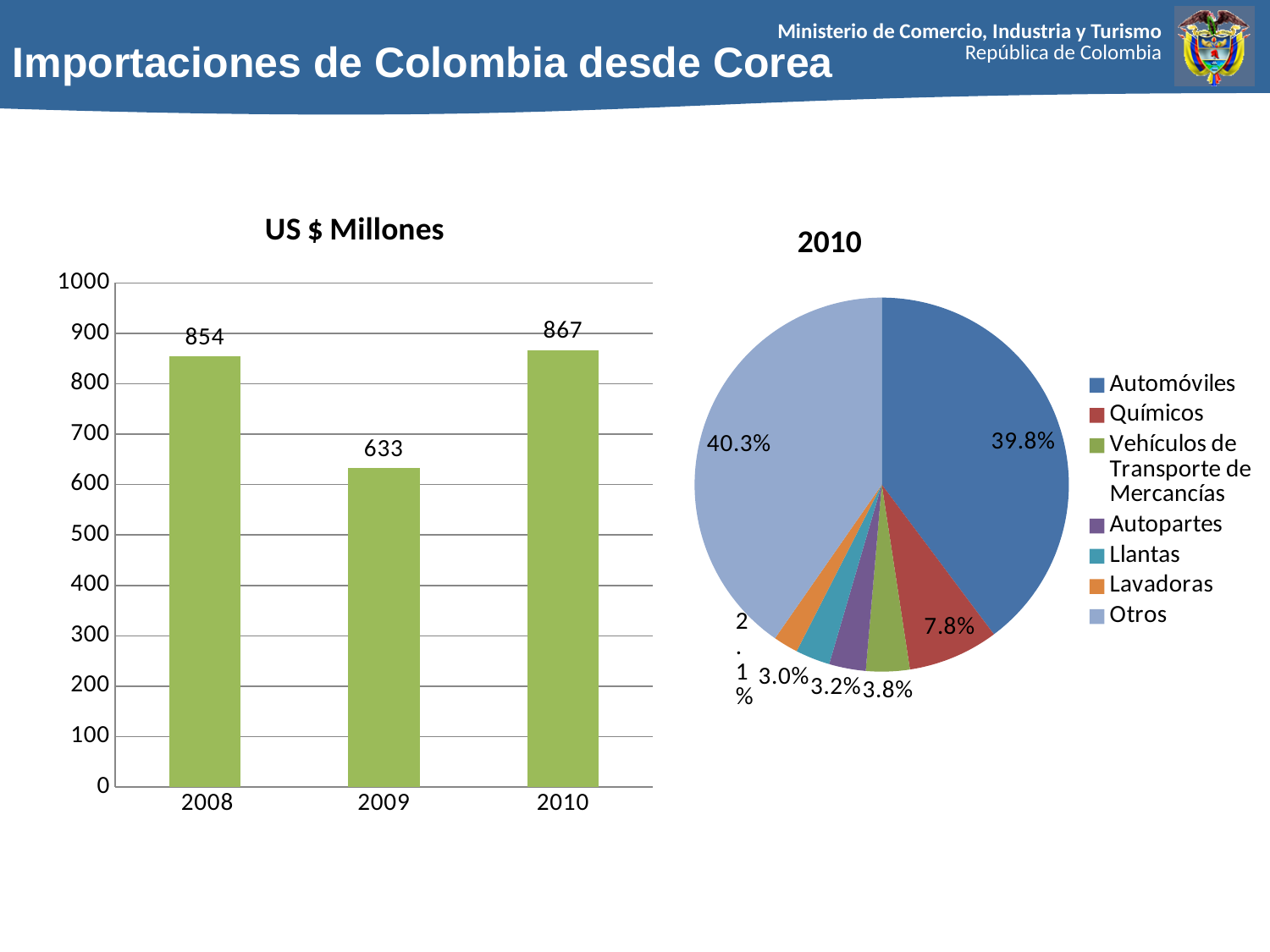
In the 'US $ Millones' bar chart, which is larger, the value for 2008 or the value for 2010? 2010 How many categories does the legend of the '2010' pie chart list? 7 How many bars are in the 'US $ Millones' bar chart? 3 In the 'US $ Millones' bar chart, what is the value for 2010? 867 In the 'US $ Millones' bar chart, which year has the lowest value? 2009 What kind of chart is the chart titled 'US $ Millones'? Bar chart In the 'US $ Millones' bar chart, which year has the highest value? 2010 In the '2010' pie chart, what share does Químicos have? 7.8% In the '2010' pie chart, what share does Automóviles have? 39.8% In the '2010' pie chart, which category has the largest share? Otros In the 'US $ Millones' bar chart, what is the difference between the values for 2008 and 2009? 221 In the 'US $ Millones' bar chart, what is the value for 2009? 633